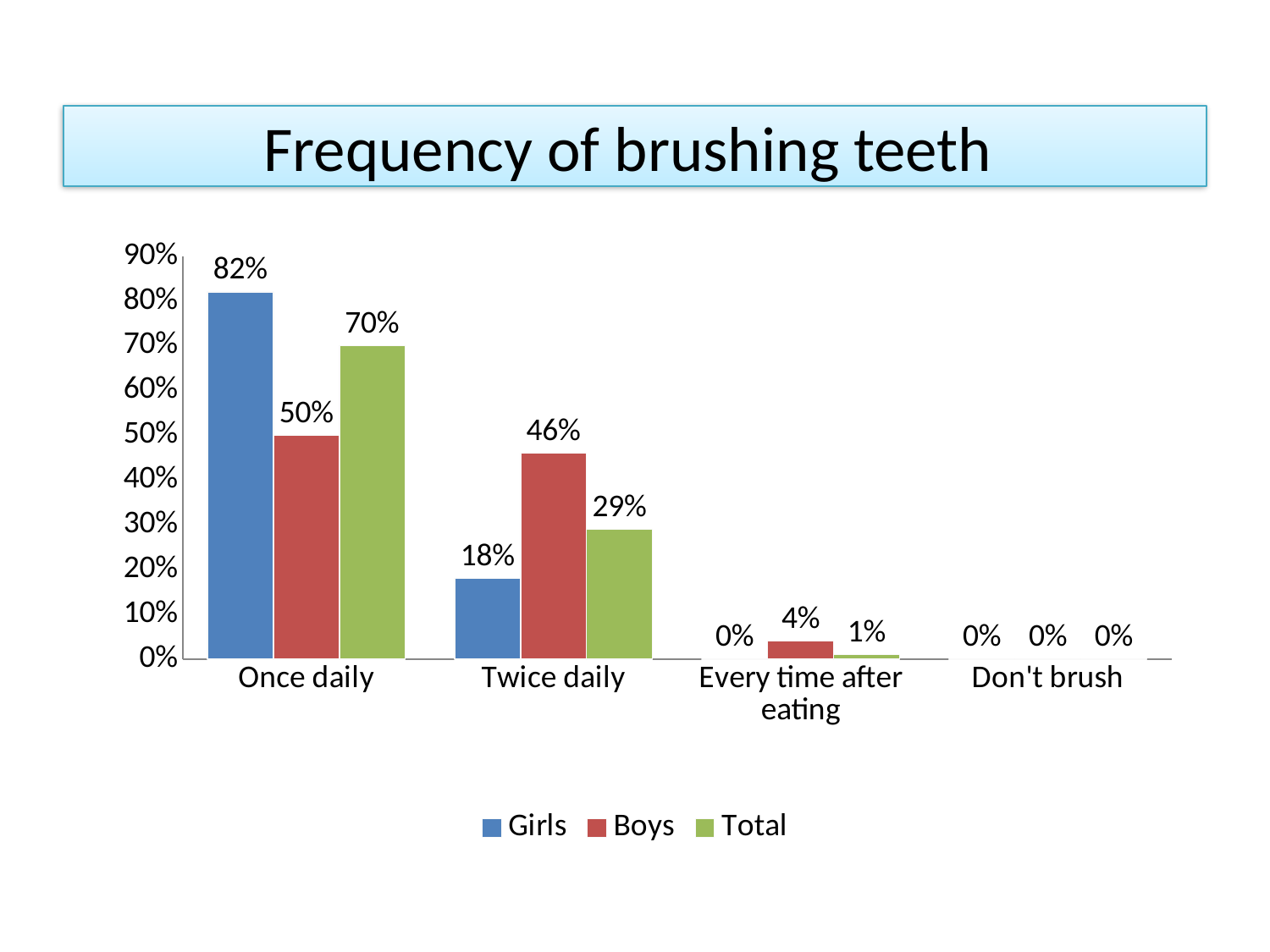
What kind of chart is shown on the slide? Bar chart What is the value for Boys in the Twice daily category? 46% What is the difference between the Girls and Boys values for Once daily? 32% Do the Total values rise or fall from Once daily to Don't brush? Fall Which category has the highest value for Girls? Once daily How many categories are shown on the x axis? 4 Which series has the lowest value in the Twice daily category? Girls What percentage of girls brush their teeth once daily? 82% What is the title of the chart? Frequency of brushing teeth How many series does the legend list? 3 What is the Total value for Every time after eating? 1% Which is larger for Twice daily: the Boys value or the Total value? Boys